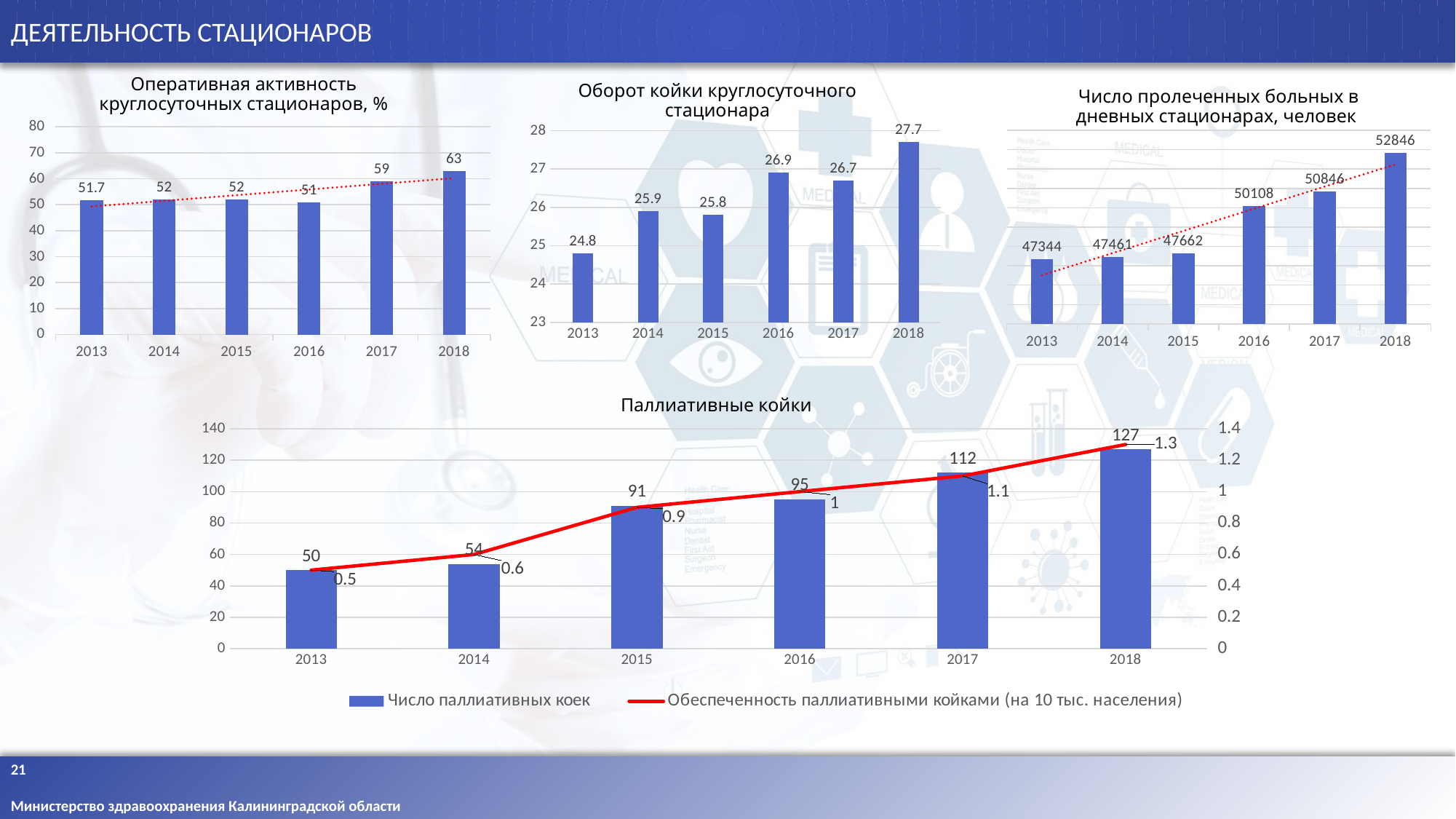
In the chart 'Оборот койки круглосуточного стационара', what is the value for 2013? 24.8 In the chart 'Паллиативные койки', what is the value of 'Число паллиативных коек' for 2017? 112 In the chart 'Число пролеченных больных в дневных стационарах, человек', what is the difference between the 2018 and 2017 values? 2000 In the chart 'Оборот койки круглосуточного стационара', which year has the highest value? 2018 In the chart 'Число пролеченных больных в дневных стационарах, человек', how many years are shown on the x axis? 6 In the chart 'Паллиативные койки', what is the value of 'Обеспеченность паллиативными койками (на 10 тыс. населения)' for 2015? 0.9 In the chart 'Паллиативные койки', how many series does the legend list? 2 In the chart 'Оперативная активность круглосуточных стационаров, %', what is the value for 2018? 63 In the chart 'Оборот койки круглосуточного стационара', what is the difference between the 2018 and 2013 values? 2.9 In the chart 'Число пролеченных больных в дневных стационарах, человек', what is the value for 2016? 50108 In the chart 'Паллиативные койки', do the values of 'Число паллиативных коек' rise or fall from 2013 to 2018? rise In the chart 'Оперативная активность круглосуточных стационаров, %', which year has the lowest value? 2016